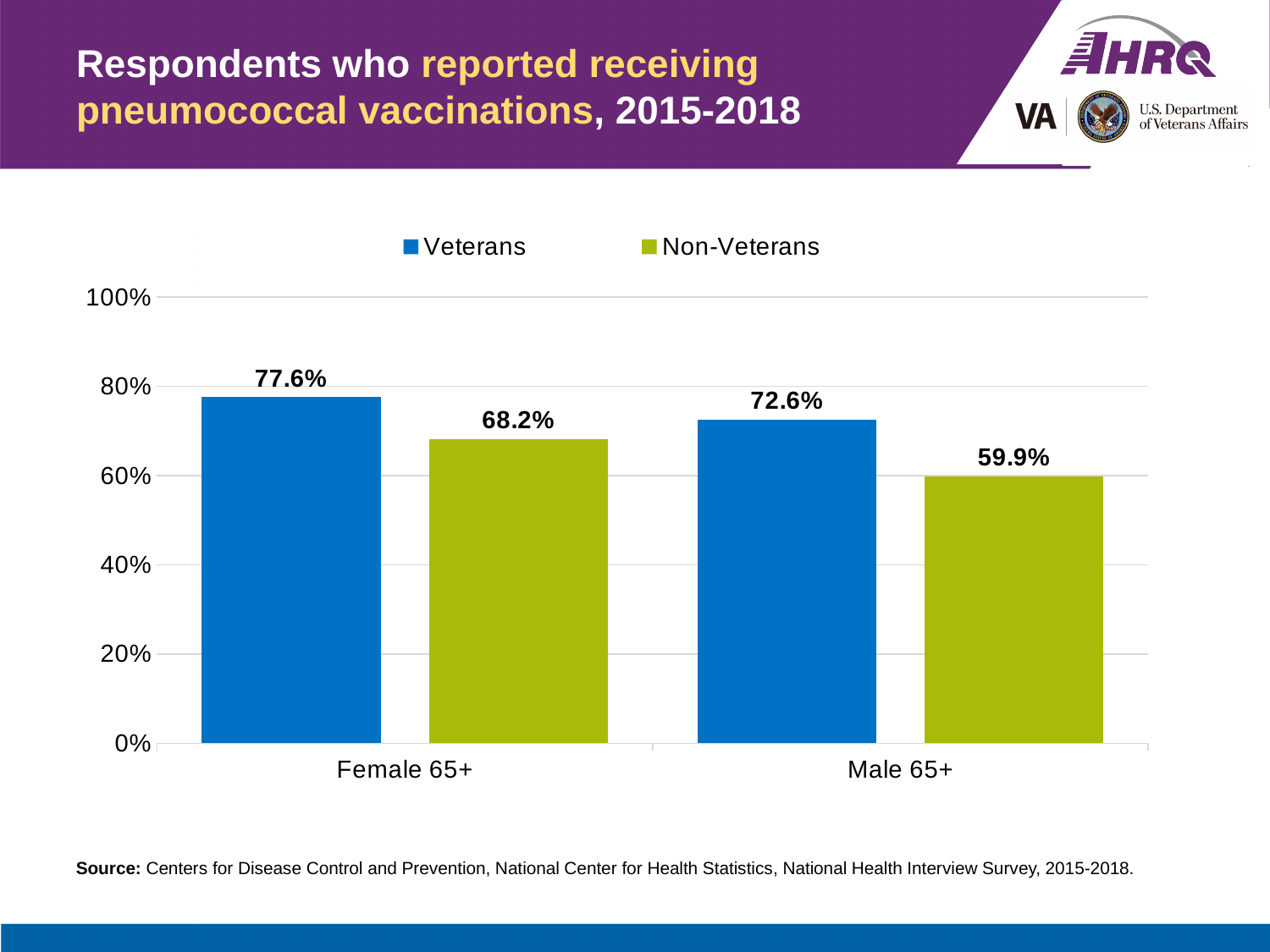
What is the difference between Veterans and Non-Veterans in the Female 65+ category? 9.4% Which bar has the lowest value on the chart? Non-Veterans, Male 65+ What percentage of female veterans aged 65+ reported receiving pneumococcal vaccinations? 77.6% What kind of chart is shown on the slide? Bar chart How many categories are shown on the x axis? 2 What is the value for Veterans in the Male 65+ category? 72.6% How many series does the legend list? 2 Which bar has the highest value on the chart? Veterans, Female 65+ What is the value for Non-Veterans in the Male 65+ category? 59.9% What is the value for Non-Veterans in the Female 65+ category? 68.2% Which is larger: the Veterans value for Male 65+ or the Non-Veterans value for Female 65+? Veterans, Male 65+ What is the difference between Veterans and Non-Veterans in the Male 65+ category? 12.7%